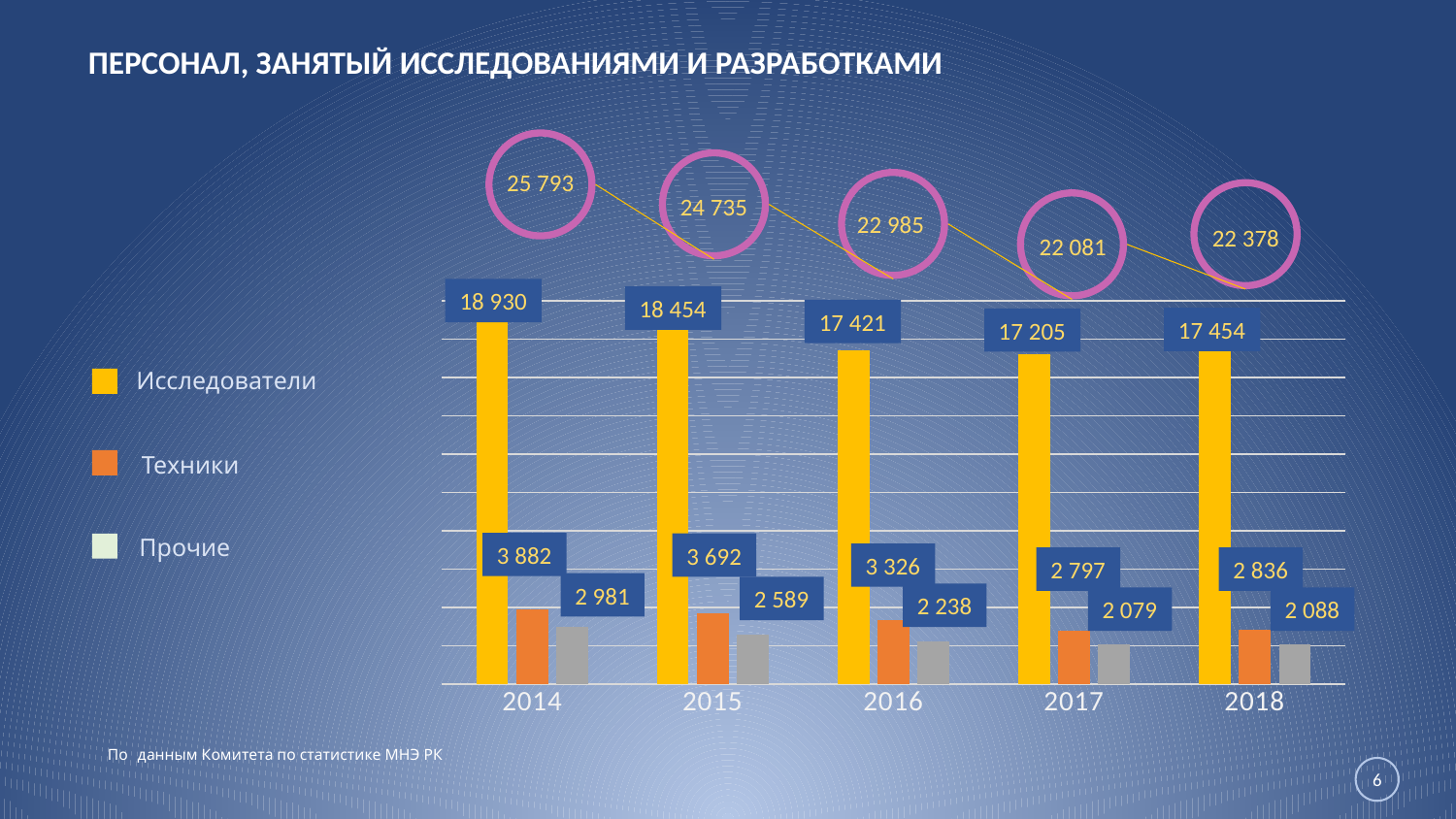
In which year is the value for Техники the highest? 2014 What is the value for Техники in 2016? 3 326 What is the value for Исследователи in 2014? 18 930 What is the difference between the Исследователи values for 2014 and 2018? 1 476 How many years are shown on the x axis? 5 What total is shown in the circle above 2015? 24 735 What kind of chart is this? bar chart In which year is the value for Исследователи the lowest? 2017 Do the values for Техники rise or fall from 2014 to 2017? fall How many series does the legend list? 3 Which is larger: Прочие in 2015 or Прочие in 2016? Прочие in 2015 What is the value for Прочие in 2018? 2 088